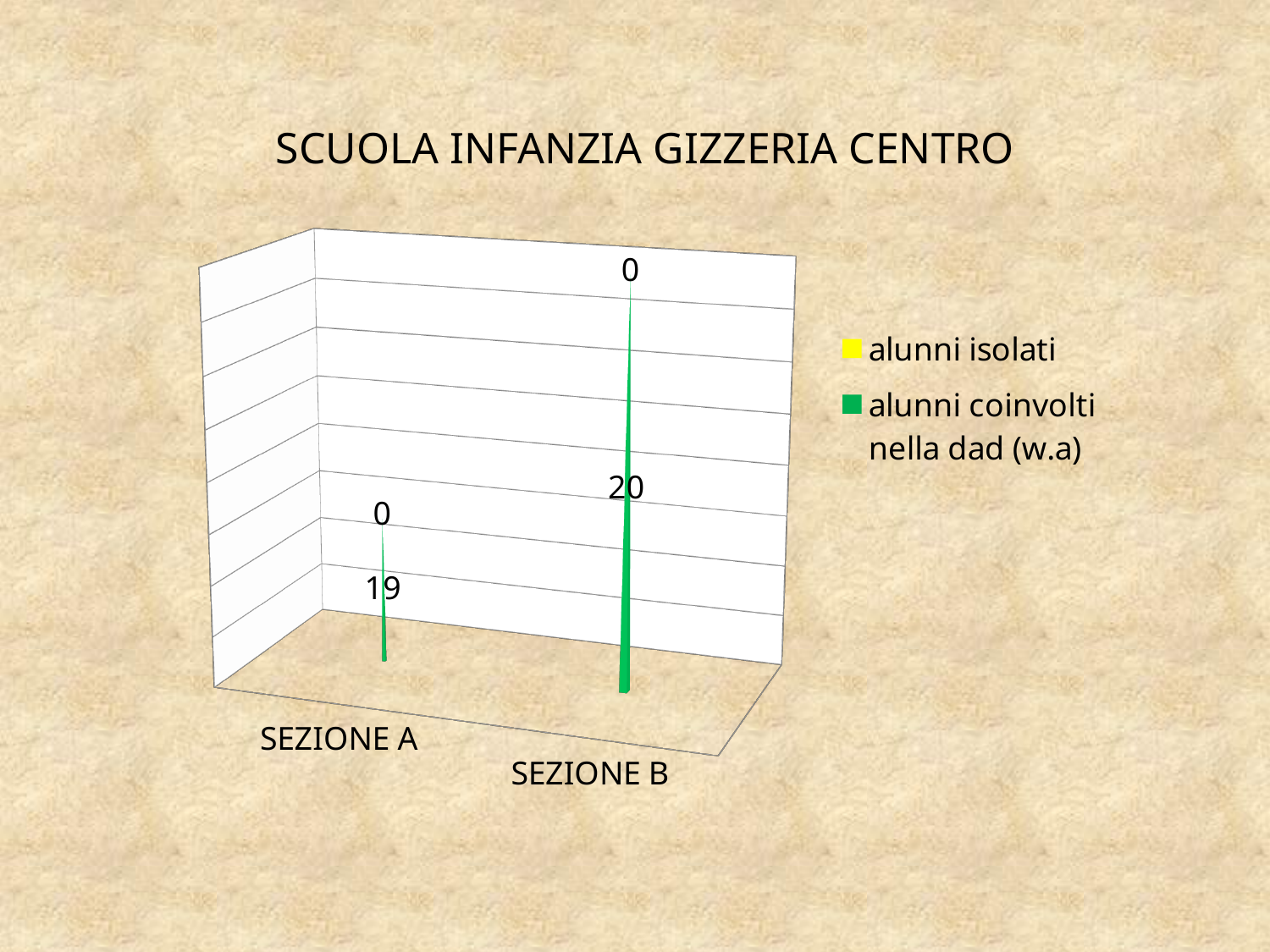
How many series does the legend list? 2 What is the difference between the 'alunni coinvolti nella dad (w.a)' values for SEZIONE B and SEZIONE A? 1 What is the title of the chart? SCUOLA INFANZIA GIZZERIA CENTRO Which section has the higher value for 'alunni coinvolti nella dad (w.a)'? SEZIONE B How many categories (sections) are shown on the x axis? 2 What is the value for 'alunni coinvolti nella dad (w.a)' in SEZIONE B? 20 What is the value for 'alunni isolati' in SEZIONE B? 0 Which section has the lower value for 'alunni coinvolti nella dad (w.a)'? SEZIONE A Is the 'alunni coinvolti nella dad (w.a)' value larger in SEZIONE A or SEZIONE B? SEZIONE B What kind of chart is shown on the slide? Bar chart What is the value for 'alunni coinvolti nella dad (w.a)' in SEZIONE A? 19 What is the value for 'alunni isolati' in SEZIONE A? 0